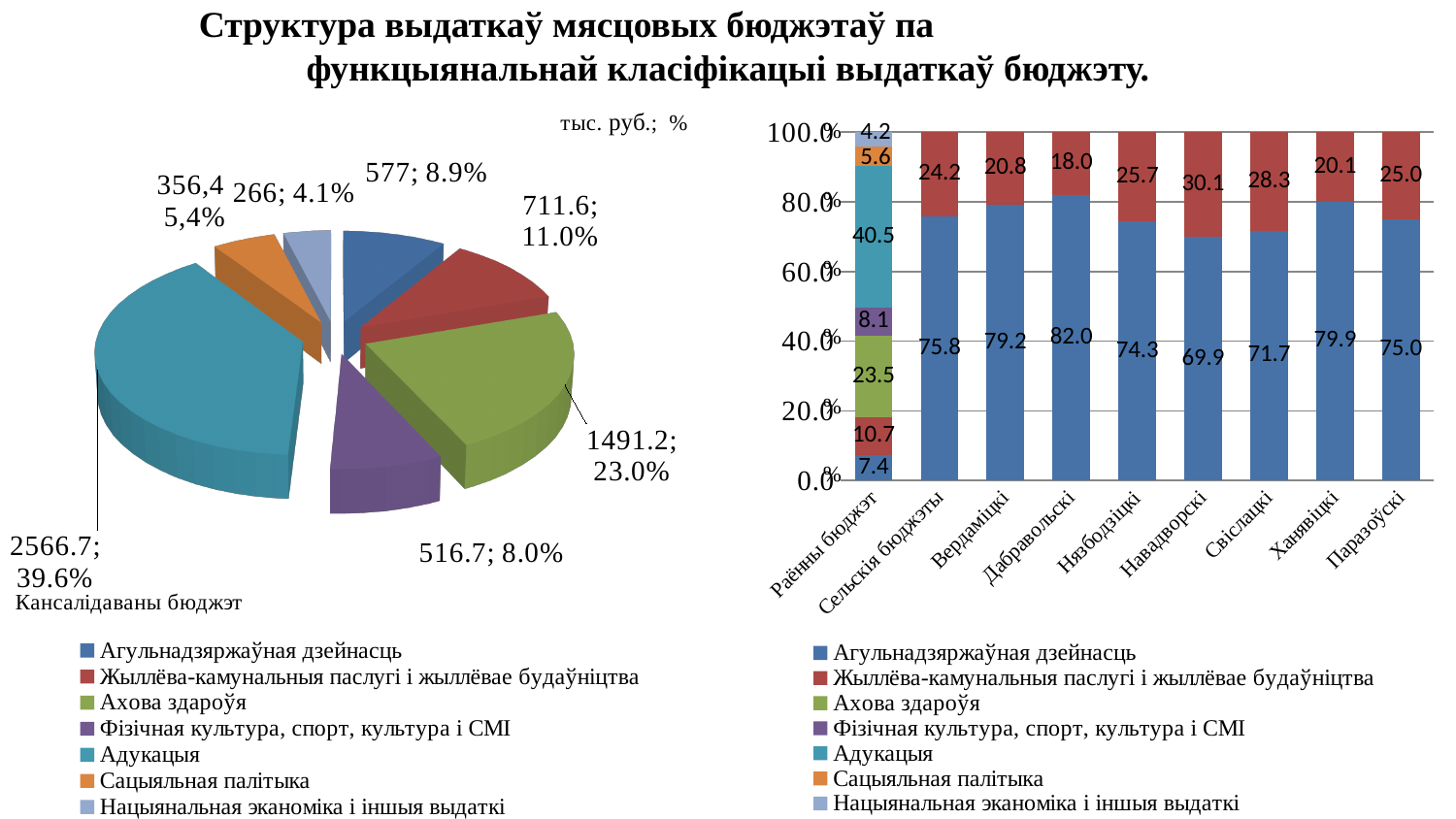
In the pie chart on the left, which category has the smallest share? Нацыянальная эканоміка і іншыя выдаткі How many categories are shown on the x axis of the stacked bar chart on the right? 9 In the pie chart on the left, what value is shown for Ахова здароўя? 1491.2 What type of chart is shown on the left of the slide? Pie chart In the stacked bar chart on the right, what is the value of Агульнадзяржаўная дзейнасць for Дабравольскі? 82.0 In the stacked bar chart on the right, which category has the highest value for Жыллёва-камунальныя паслугі і жыллёвае будаўніцтва? Навадворскі In the pie chart on the left, what is the share of Адукацыя? 39.6% How many series does the legend of the stacked bar chart on the right list? 7 In the stacked bar chart on the right, what is the value of Адукацыя for Раённы бюджэт? 40.5 In the pie chart on the left, which is larger: Жыллёва-камунальныя паслугі і жыллёвае будаўніцтва or Фізічная культура, спорт, культура і СМІ? Жыллёва-камунальныя паслугі і жыллёвае будаўніцтва In the pie chart on the left, which category has the largest share? Адукацыя In the stacked bar chart on the right, what is the difference between the Агульнадзяржаўная дзейнасць values for Дабравольскі and Навадворскі? 12.1